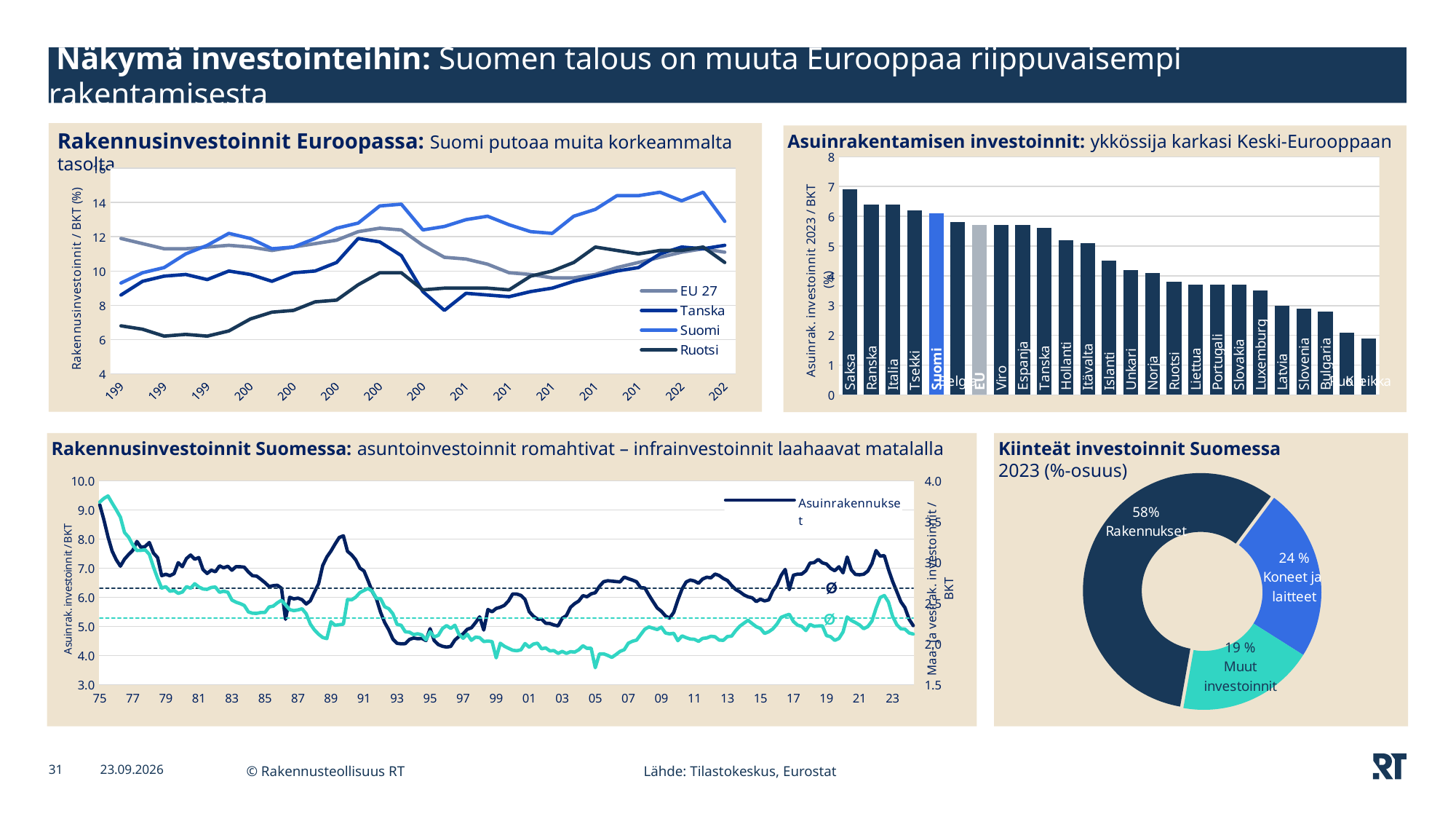
In the 'Kiinteät investoinnit Suomessa' donut chart, how many categories are shown? 3 In the 'Kiinteät investoinnit Suomessa' donut chart, what share do Muut investoinnit have? 19 % In the 'Asuinrakentamisen investoinnit' bar chart, is the value for Islanti greater or less than 4? greater What kind of chart is the 'Rakennusinvestoinnit Euroopassa' chart? line chart In the 'Asuinrakentamisen investoinnit' bar chart, which country has the highest value? Saksa In the 'Kiinteät investoinnit Suomessa' donut chart, what share do Koneet ja laitteet have? 24 % In the 'Kiinteät investoinnit Suomessa' donut chart, which category has the largest share? Rakennukset In the 'Asuinrakentamisen investoinnit' bar chart, is the value for Saksa greater or less than 6? greater In the 'Kiinteät investoinnit Suomessa' donut chart, what share do Rakennukset have? 58% In the 'Asuinrakentamisen investoinnit' bar chart, which country has the lowest value? Kreikka In the 'Asuinrakentamisen investoinnit' bar chart, which is larger, the value for Suomi or the value for Ruotsi? Suomi How many series does the legend of the 'Rakennusinvestoinnit Euroopassa' chart list? 4